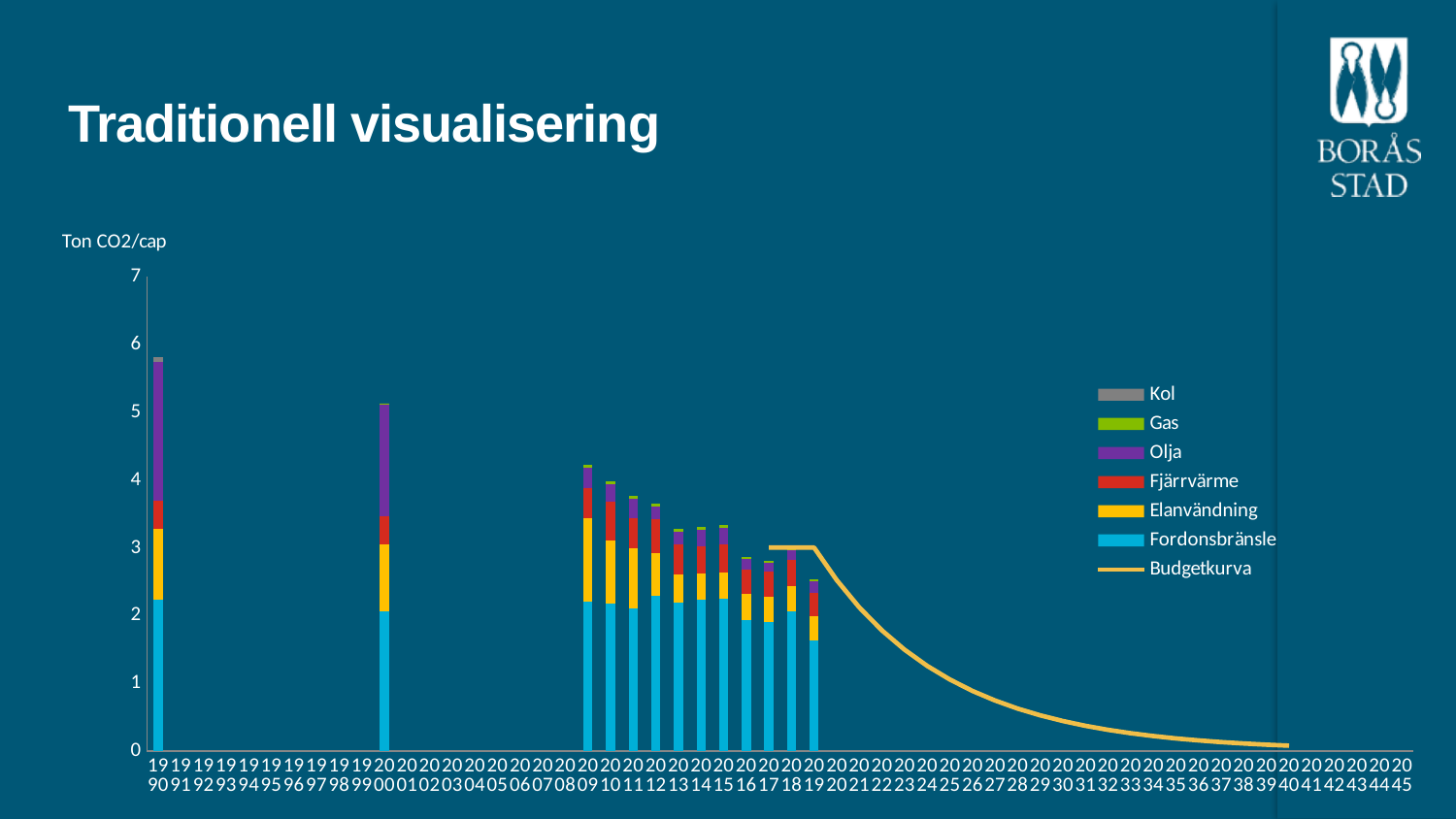
How many entries does the chart legend list? 7 Is the total value of the 2000 bar greater or less than 4? greater Is the total value of the 2019 bar greater or less than 3? less What kind of chart is shown on the slide? Stacked bar chart with a line What is the unit label shown above the vertical axis? Ton CO2/cap Which legend entry is shown as a line rather than a bar? Budgetkurva Which year has the tallest stacked bar? 1990 Do the stacked bars generally rise or fall from 2009 to 2019? fall Which stacked bar is taller, 1990 or 2000? 1990 Is the total value of the 1990 bar greater or less than 5? greater Which year has the shortest stacked bar? 2019 Does the Budgetkurva line rise or fall after 2019? fall